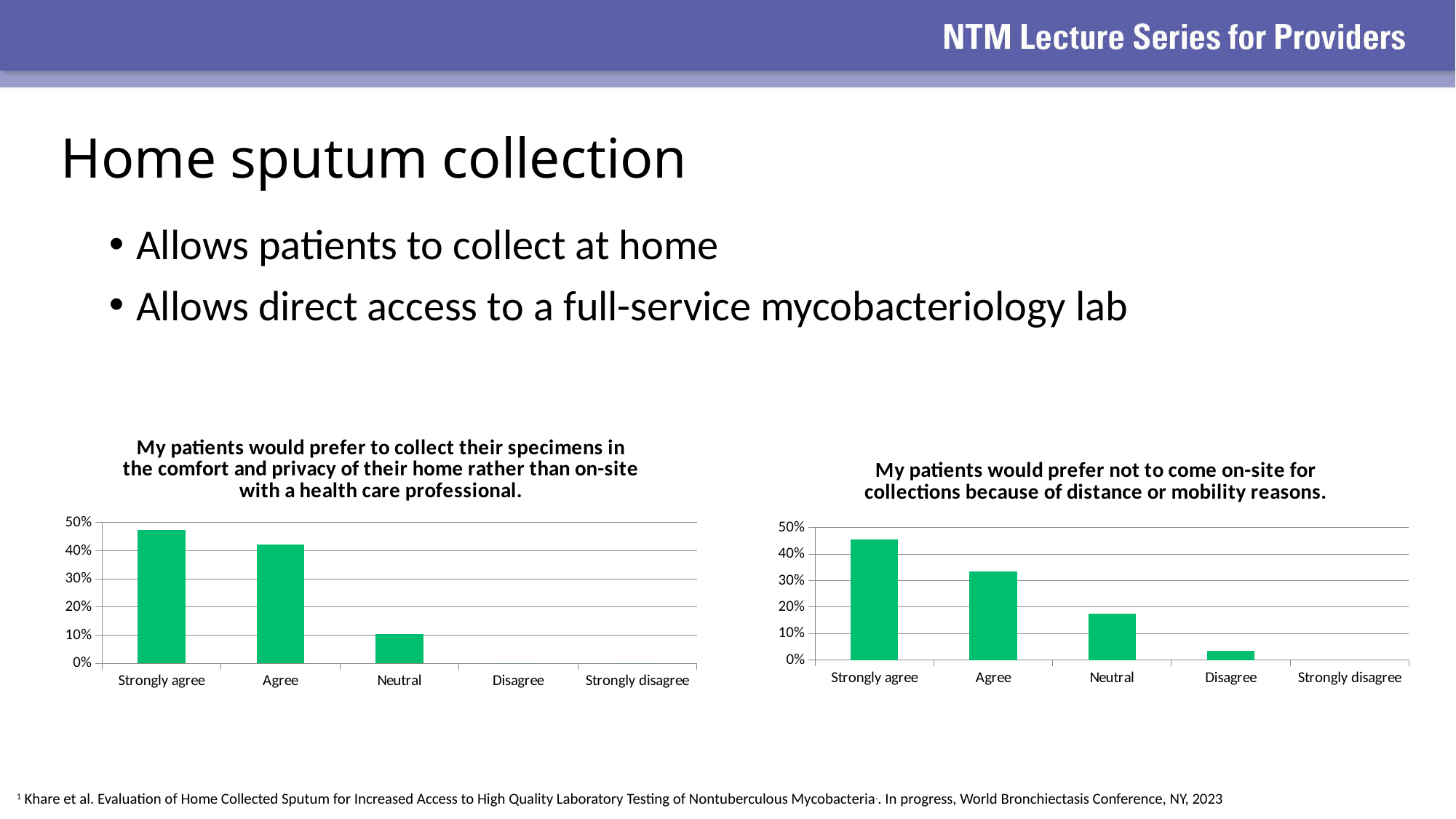
In the left chart ("My patients would prefer to collect their specimens in the comfort and privacy of their home..."), do the values rise or fall moving from Strongly agree to Strongly disagree? Fall In the right chart ("My patients would prefer not to come on-site for collections because of distance or mobility reasons."), is the value for Agree greater or less than 30%? greater In the right chart ("My patients would prefer not to come on-site for collections because of distance or mobility reasons."), is the value for Disagree greater or less than 10%? less In the left chart ("My patients would prefer to collect their specimens in the comfort and privacy of their home..."), is the value for Neutral greater or less than 20%? less In the right chart ("My patients would prefer not to come on-site for collections because of distance or mobility reasons."), which is larger, the value for Neutral or the value for Disagree? Neutral What colour are the bars in both charts on the slide? Green In the left chart ("My patients would prefer to collect their specimens in the comfort and privacy of their home..."), which response category has the highest value? Strongly agree In the left chart ("My patients would prefer to collect their specimens in the comfort and privacy of their home..."), what kind of chart is shown? Bar chart In the left chart ("My patients would prefer to collect their specimens in the comfort and privacy of their home..."), how many response categories are shown on the x axis? 5 In the right chart ("My patients would prefer not to come on-site for collections because of distance or mobility reasons."), which response category has the highest value? Strongly agree